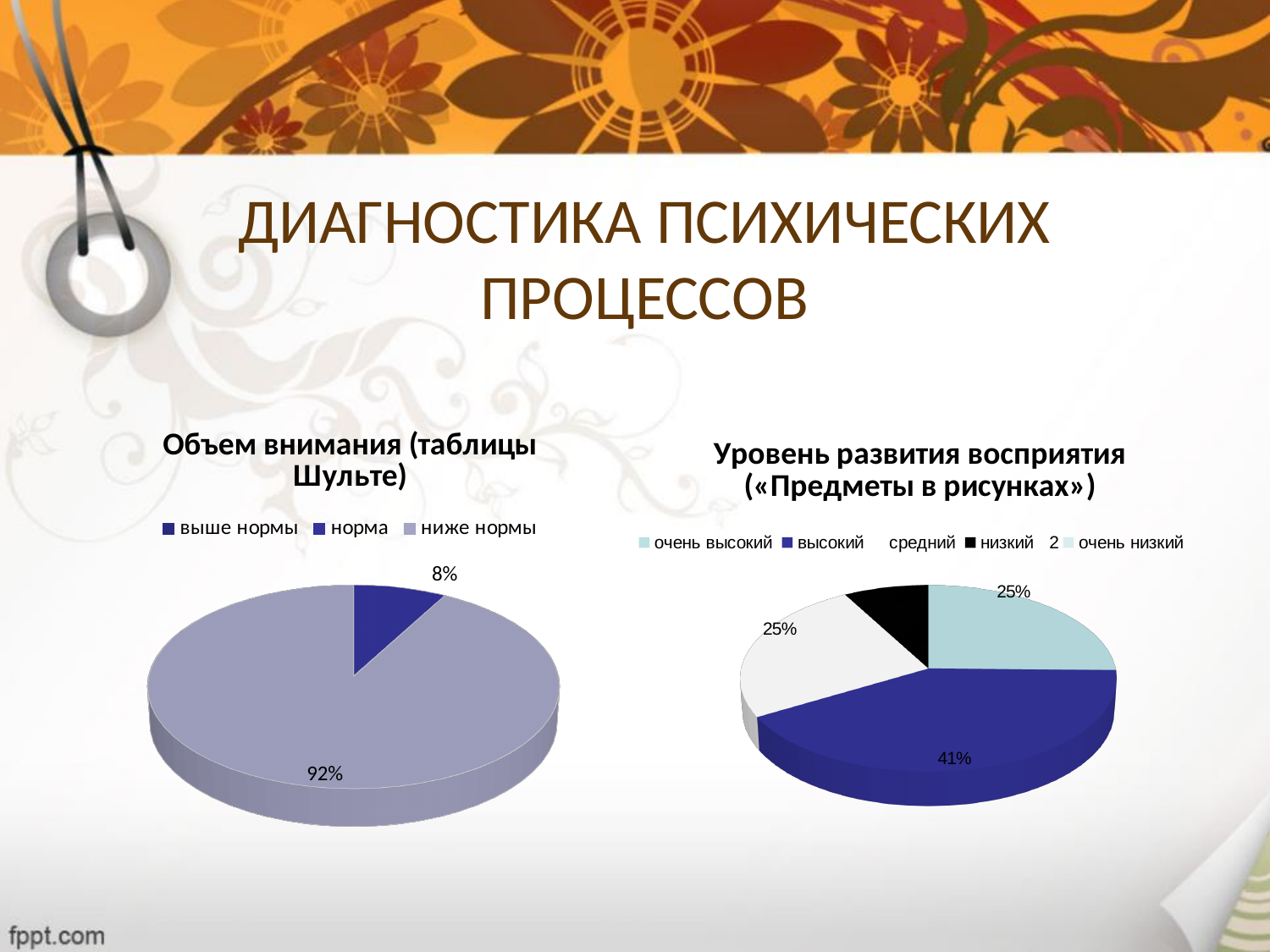
What kind of chart is the left chart, 'Объем внимания (таблицы Шульте)'? Pie chart In the right chart 'Уровень развития восприятия', which is larger: 'высокий' or 'очень высокий'? высокий In the right chart 'Уровень развития восприятия', which category has the largest slice? высокий How many slices are visible in the right chart 'Уровень развития восприятия'? 4 In the right chart 'Уровень развития восприятия', what is the difference between 'высокий' and 'очень высокий'? 16 percentage points In the right chart 'Уровень развития восприятия', what percentage is shown for 'высокий'? 41% In the left chart 'Объем внимания (таблицы Шульте)', what is the difference between the 92% slice and the 8% slice? 84 percentage points In the left chart 'Объем внимания (таблицы Шульте)', which category has the largest slice? ниже нормы In the right chart 'Уровень развития восприятия', what percentage is shown for 'очень высокий'? 25% How many entries does the legend of the left chart 'Объем внимания (таблицы Шульте)' list? 3 In the left chart 'Объем внимания (таблицы Шульте)', what percentage is shown for 'ниже нормы'? 92% What kind of chart is the right chart, 'Уровень развития восприятия («Предметы в рисунках»)'? Pie chart